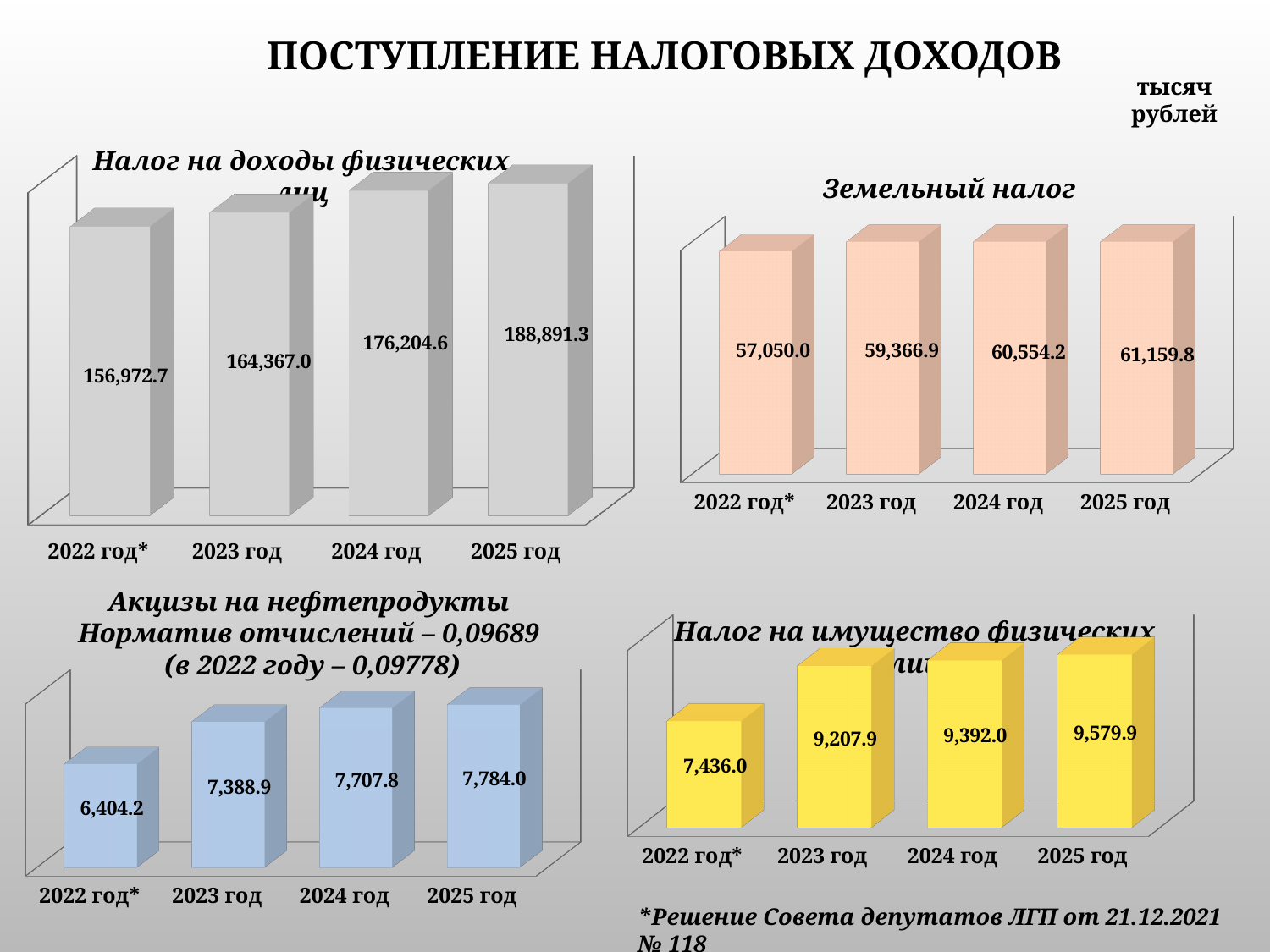
In the 'Земельный налог' chart, which year has the lowest value? 2022 год* In the 'Налог на доходы физических лиц' chart, do the values rise or fall from 2022 год* to 2025 год? Rise In the 'Налог на имущество физических лиц' chart, which year has the highest value? 2025 год In the 'Акцизы на нефтепродукты' chart, what is the value for 2022 год*? 6,404.2 How many years are shown in the 'Земельный налог' chart? 4 In the 'Акцизы на нефтепродукты' chart, which is larger: the value for 2023 год or the value for 2024 год? 2024 год What kind of chart is the 'Налог на имущество физических лиц' chart? Bar chart In the 'Налог на доходы физических лиц' chart, what is the difference between the values for 2025 год and 2022 год*? 31,918.6 In the 'Земельный налог' chart, what is the value for 2023 год? 59,366.9 In the 'Налог на имущество физических лиц' chart, what is the difference between the values for 2025 год and 2022 год*? 2,143.9 How many charts are shown on the slide? 4 In the 'Налог на доходы физических лиц' chart, what is the value for 2025 год? 188,891.3